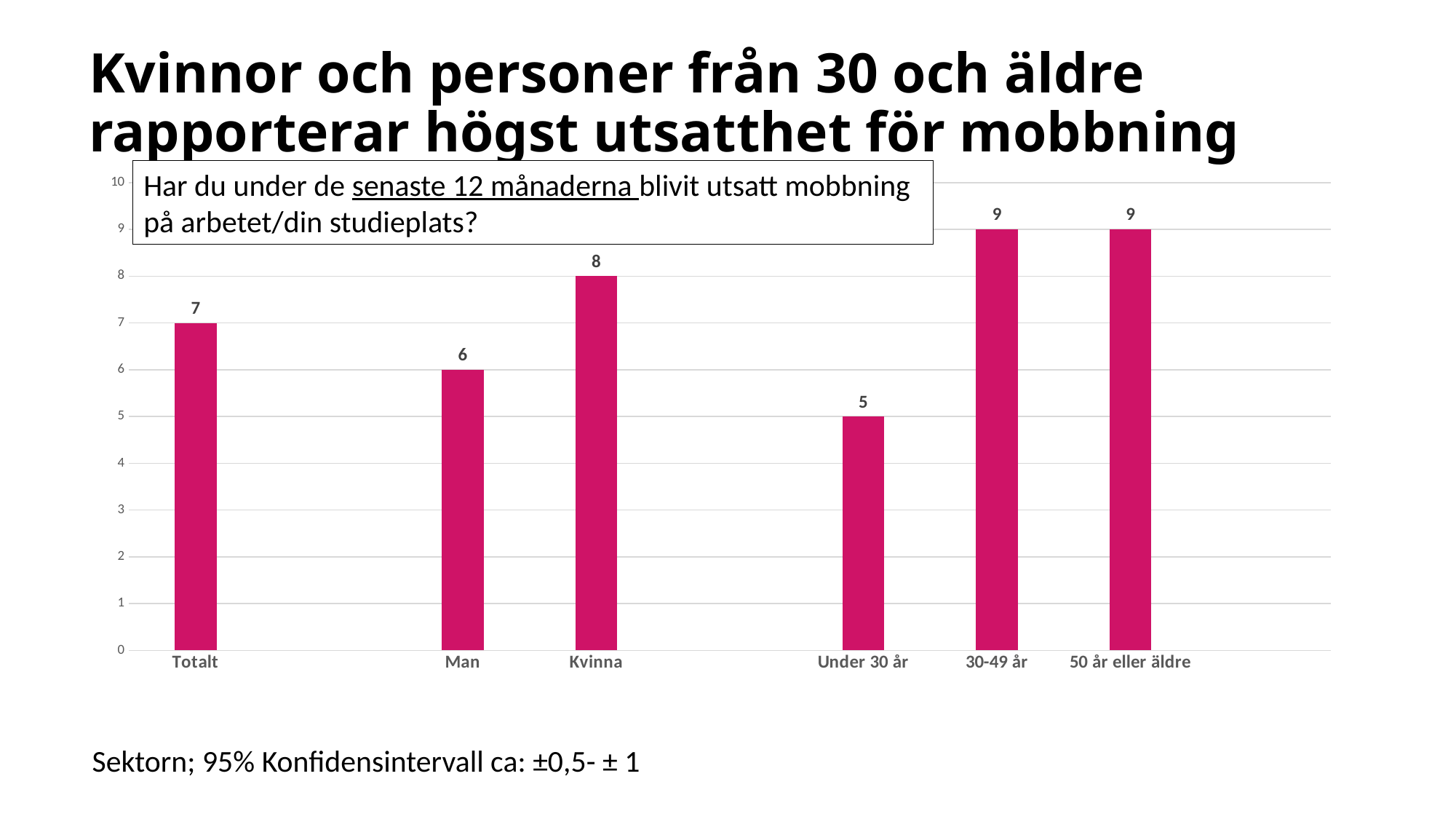
What is the difference between the values for Kvinna and Man? 2 What is the value for Kvinna? 8 How many categories are shown on the x axis? 6 What is the value for Under 30 år? 5 Is the value for 50 år eller äldre greater or less than 8? greater What is the value for Man? 6 Which category has the lowest value? Under 30 år What is the difference between the values for 30-49 år and Under 30 år? 4 What is the maximum value shown on the y axis? 10 Which is larger, the value for Kvinna or the value for Man? Kvinna What kind of chart is shown on the slide? bar chart What is the value for Totalt? 7